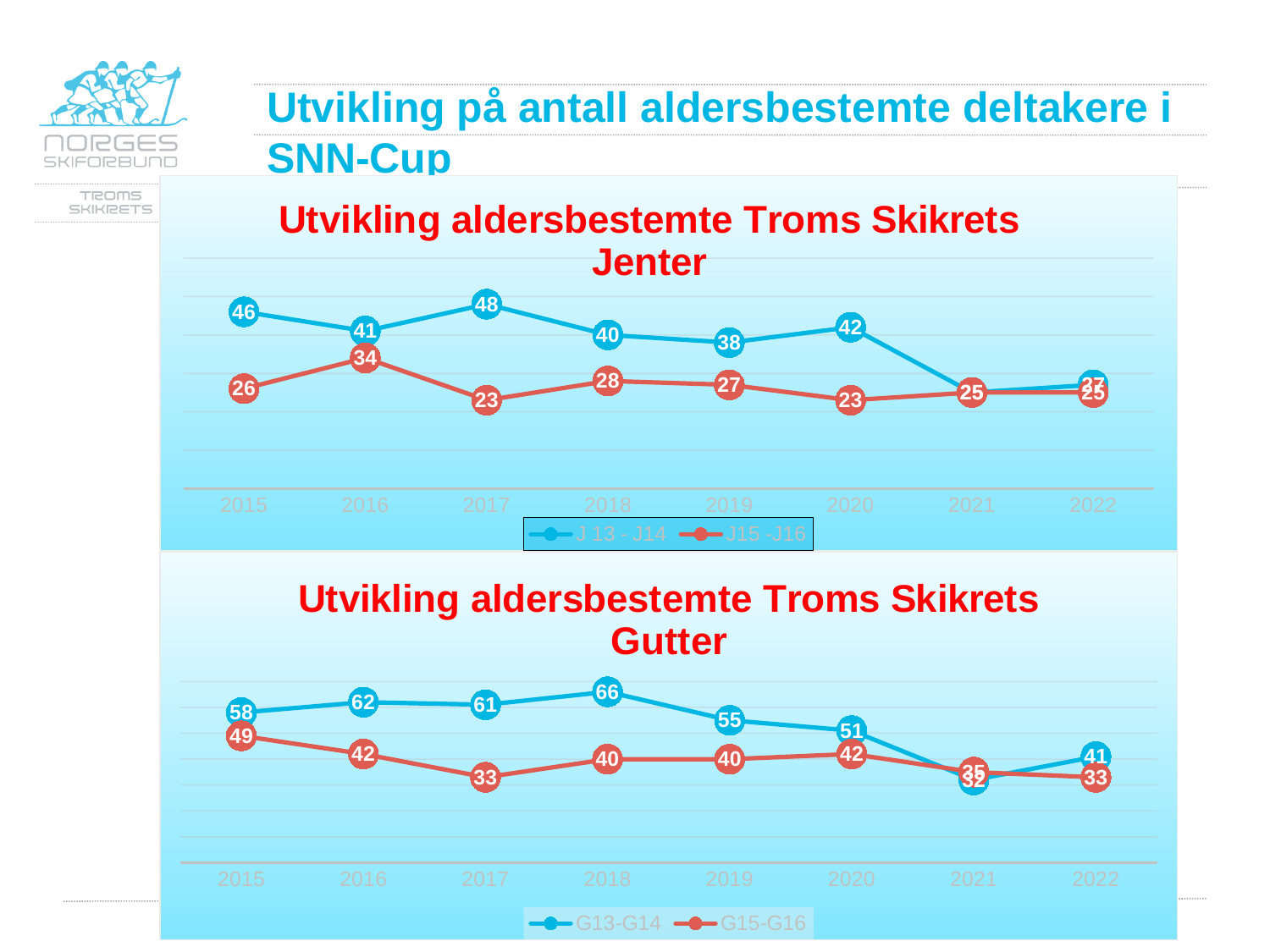
In the Gutter chart, what is the value for G15-G16 in 2017? 33 In the Gutter chart, which year has the highest value for G13-G14? 2018 What type of chart is the Jenter chart? Line chart How many years are shown on the x axis of the Gutter chart? 8 In the Gutter chart, which is larger in 2020: G13-G14 or G15-G16? G13-G14 In the Jenter chart, what is the value for J 13 - J14 in 2017? 48 In the Jenter chart, what is the value for J15 -J16 in 2016? 34 In the Jenter chart, which year has the highest value for J 13 - J14? 2017 In the Jenter chart, how many series does the legend list? 2 In the Gutter chart, what is the difference between G13-G14 and G15-G16 in 2019? 15 In the Jenter chart, what is the difference between J 13 - J14 and J15 -J16 in 2015? 20 In the Gutter chart, what is the value for G13-G14 in 2018? 66